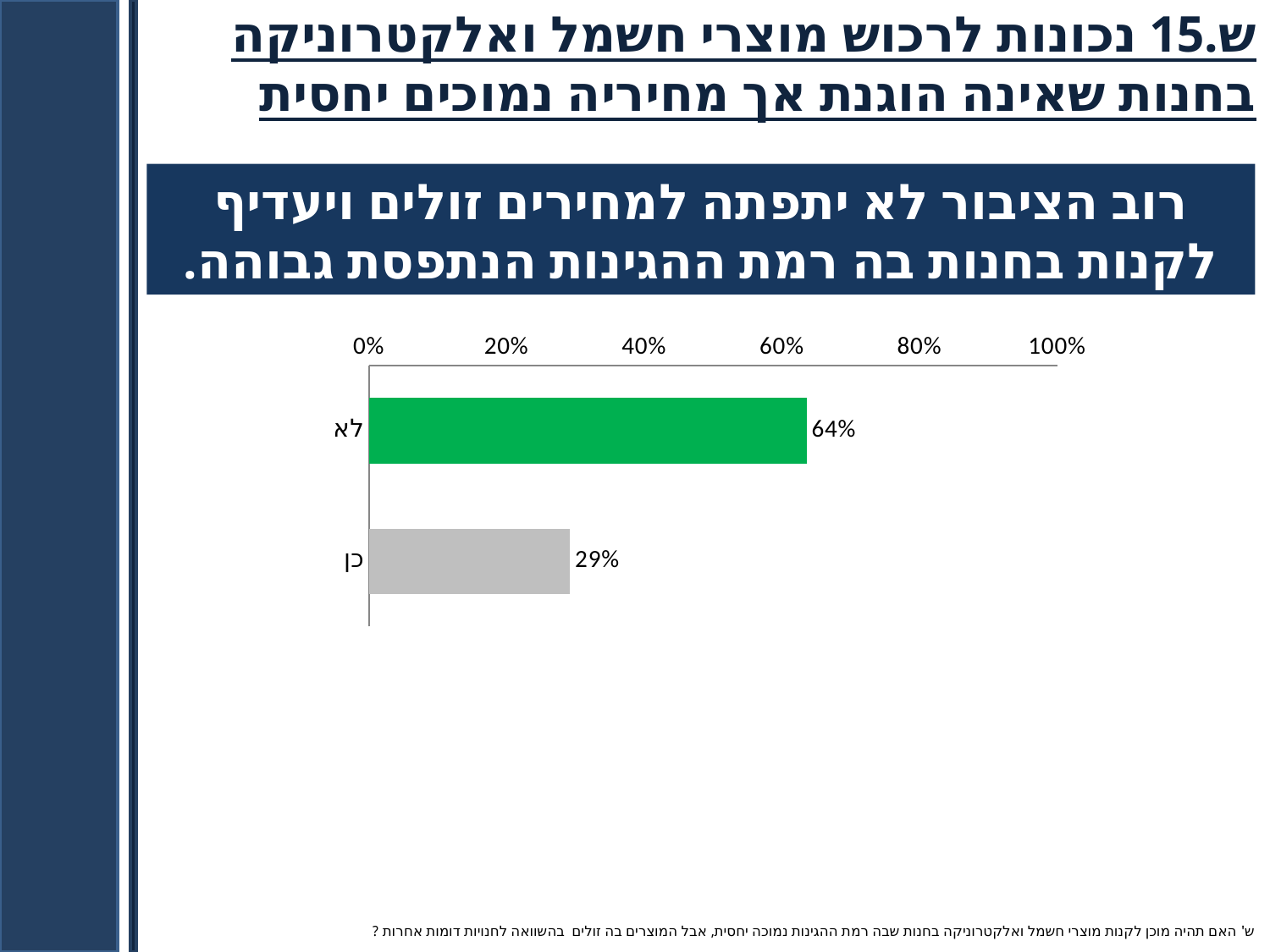
What is the highest value shown on the horizontal axis? 100% What colour is the bar for "לא"? green What is the difference between the values for "לא" and "כן"? 35% What is the value for the category "לא"? 64% Is the value for "כן" greater or less than 40%? less What kind of chart is shown on the slide? bar chart How many categories are shown in the chart? 2 What is the value for the category "כן"? 29% Which is larger, the value for "לא" or the value for "כן"? לא Which category has the lowest value? כן Which category has the highest value? לא Is the value for "לא" greater or less than 60%? greater